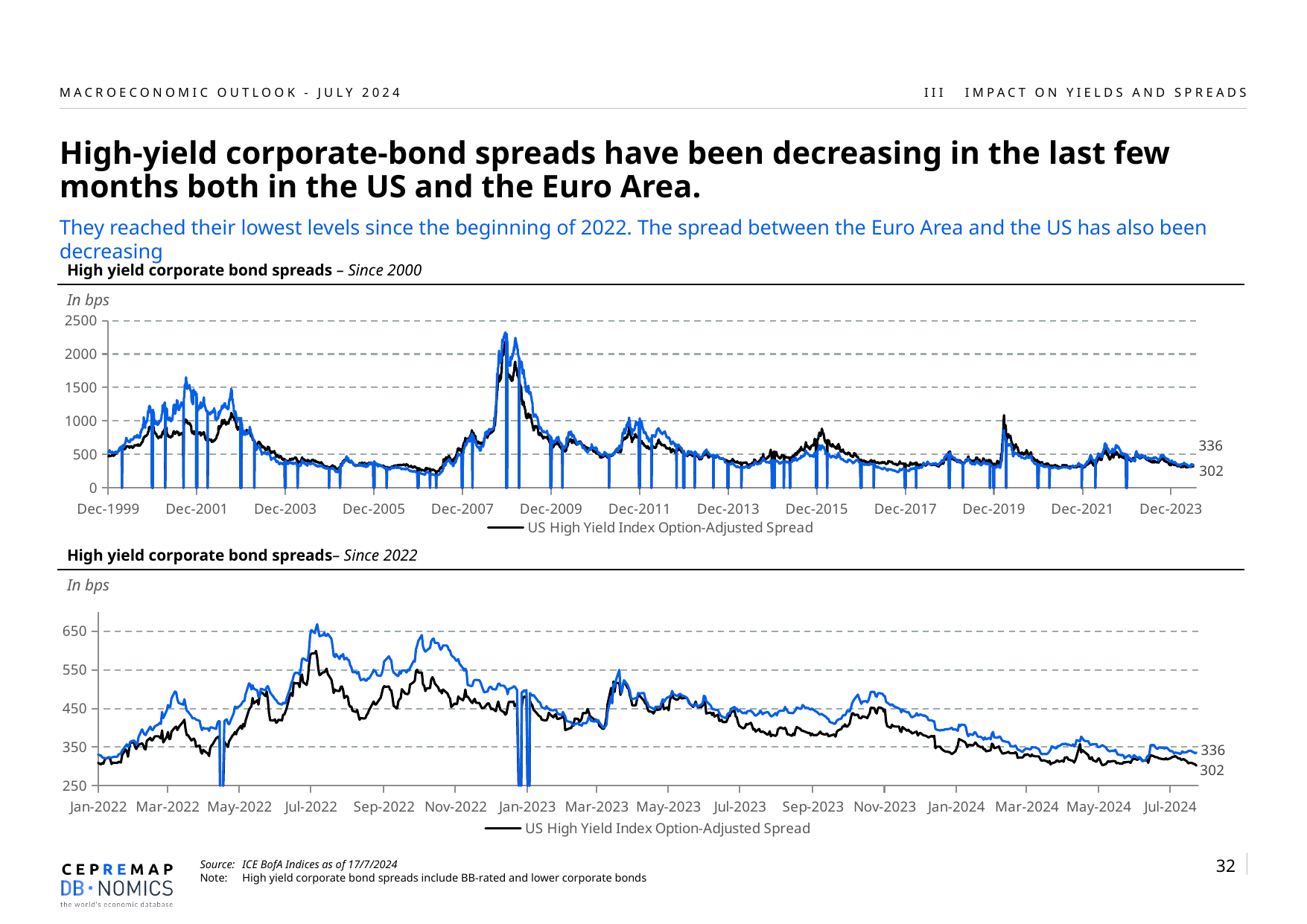
In the bottom chart (Since 2022), do the spreads rise or fall between Nov-2023 and Jul-2024? Fall In the top chart (Since 2000), what is the latest value labelled for the US High Yield Index Option-Adjusted Spread (black line)? 302 What type of chart is the top chart, 'High yield corporate bond spreads – Since 2000'? Line chart In the bottom chart (Since 2022), what is the latest value labelled at the end of the blue line? 336 In the bottom chart (Since 2022), is the peak of the US High Yield Index Option-Adjusted Spread (black line) around Jul-2022 greater or less than 550? greater In the bottom chart (Since 2022), is the value of the black line at Jan-2022 greater or less than 350? less What is the highest value shown on the y axis of the top chart (Since 2000)? 2500 In the top chart (Since 2000), is the peak of the US High Yield Index Option-Adjusted Spread around Dec-2008 greater or less than 2000? greater How many series does the legend of the top chart (Since 2000) list? 1 What unit is shown for the values in both charts? In bps In the bottom chart (Since 2022), which line ends higher in Jul-2024, the blue line or the black line? The blue line In the bottom chart (Since 2022), what is the difference between the two end-of-series labels, 336 and 302? 34